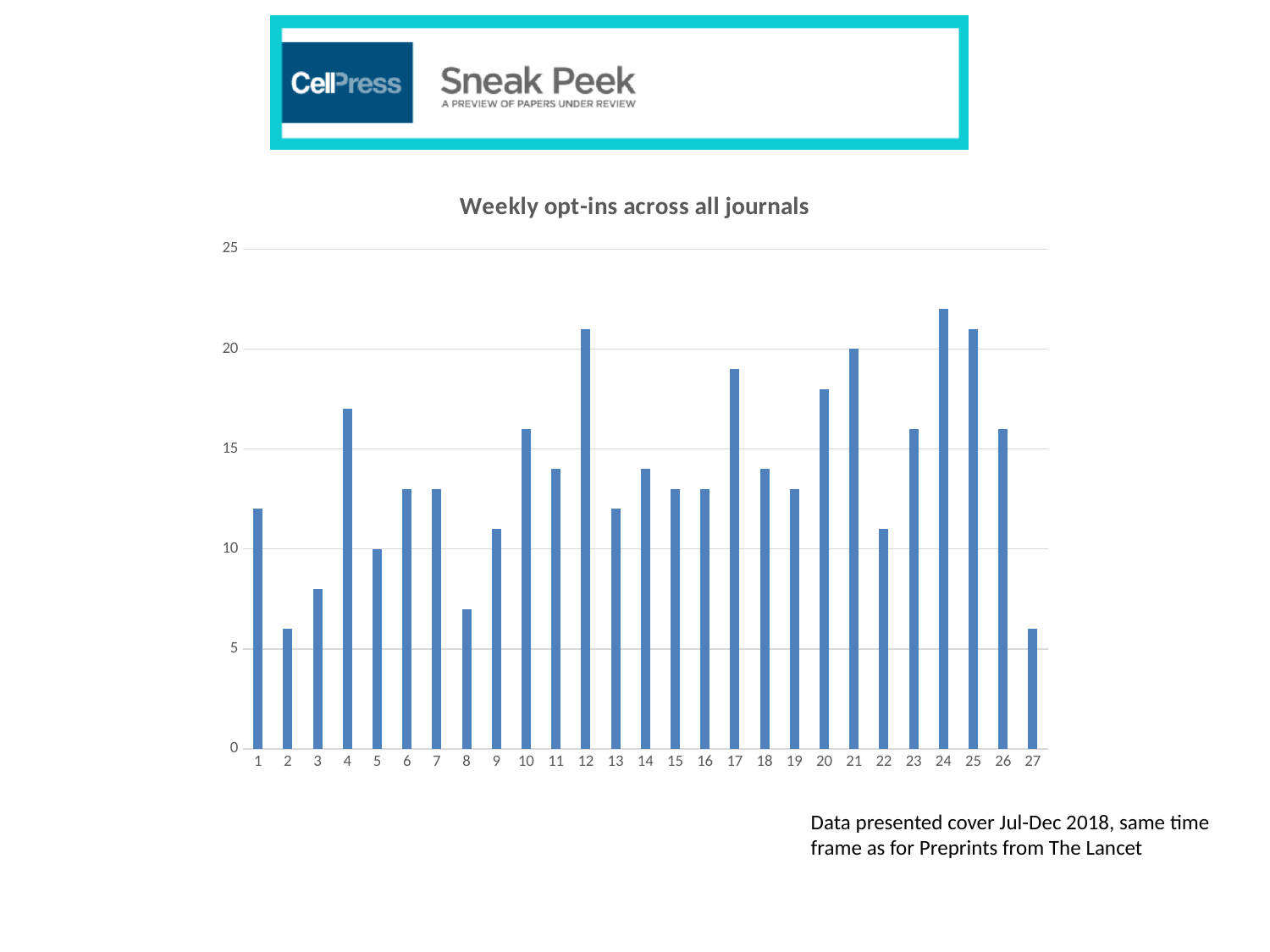
What is the title of the chart? Weekly opt-ins across all journals How many weeks (bars) are plotted on the chart? 27 Which week has the highest number of opt-ins? 24 Which has more opt-ins, week 4 or week 5? week 4 Is the value for week 2 greater or less than 10? less Is the value for week 24 greater or less than 20? greater Is the value for week 4 greater or less than 15? greater What is the value for week 5? 10 Which has more opt-ins, week 12 or week 13? week 12 What kind of chart is shown on the slide? bar chart What is the value for week 21? 20